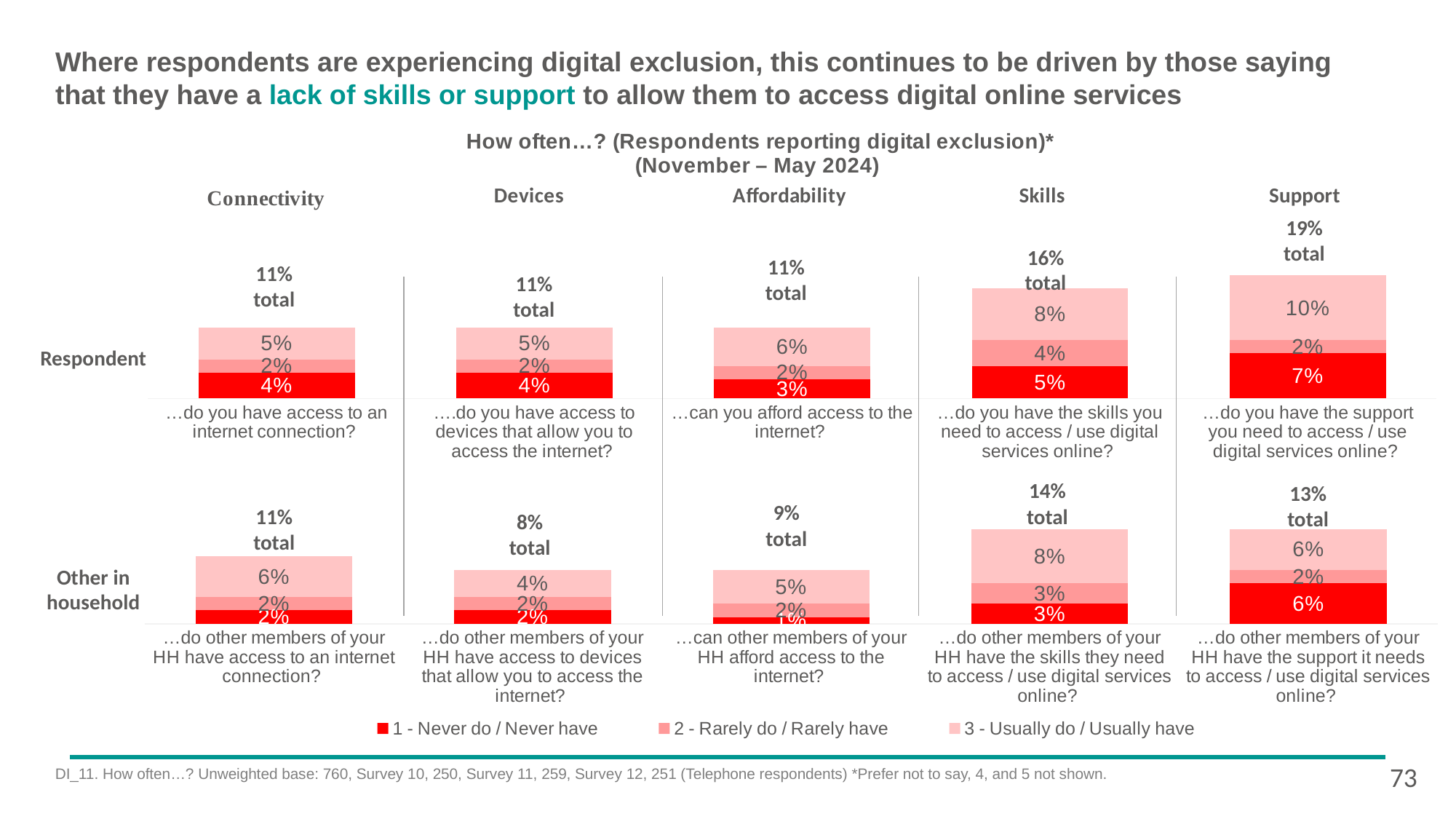
In the Respondent row, Support chart, what is the total percentage shown? 19% How many series does the legend list? 3 In the Respondent row, is the '3 - Usually do / Usually have' value larger for Skills or for Affordability? Skills What kind of chart is used to show the Respondent Connectivity data? Stacked bar chart Which colour represents '1 - Never do / Never have' in the legend? Red What is the difference between the Respondent Support total and the Respondent Connectivity total? 8% In the Other in household row, Affordability chart, what is the value for '3 - Usually do / Usually have'? 5% Across the Other in household row, which category has the lowest total? Devices Across the Respondent row, which category has the highest total? Support In the Other in household row, Skills chart, what is the total of the stacked bar? 14% In the Respondent row, Skills chart, what is the value for '1 - Never do / Never have'? 5% In the Other in household row, Support chart, what is the value for '1 - Never do / Never have'? 6%